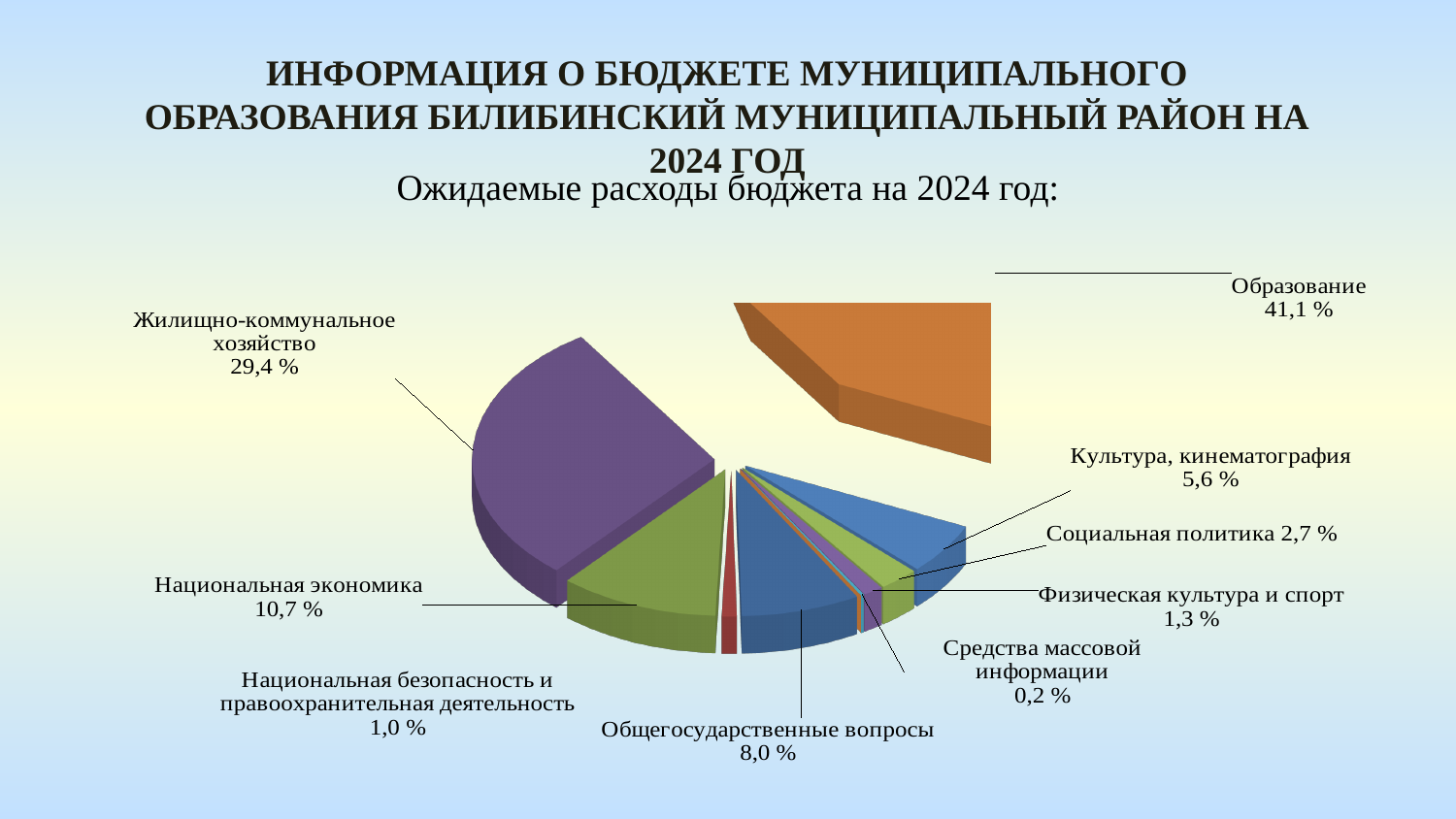
What percentage is shown for Национальная экономика? 10,7 % Which is larger: the share for Культура, кинематография or the share for Социальная политика? Культура, кинематография What is the difference in percentage points between Образование and Жилищно-коммунальное хозяйство? 11,7 Which category has the smallest share in the pie chart? Средства массовой информации What share of the pie is labelled Жилищно-коммунальное хозяйство? 29,4 % What is the subtitle above the chart? Ожидаемые расходы бюджета на 2024 год: How many categories are shown in the pie chart? 9 Which category has the largest share of expected 2024 budget expenditures? Образование What share of expected 2024 budget expenditures goes to Образование? 41,1 % What percentage is shown for Общегосударственные вопросы? 8,0 % What share is shown for Средства массовой информации? 0,2 % What type of chart is shown on the slide? Pie chart